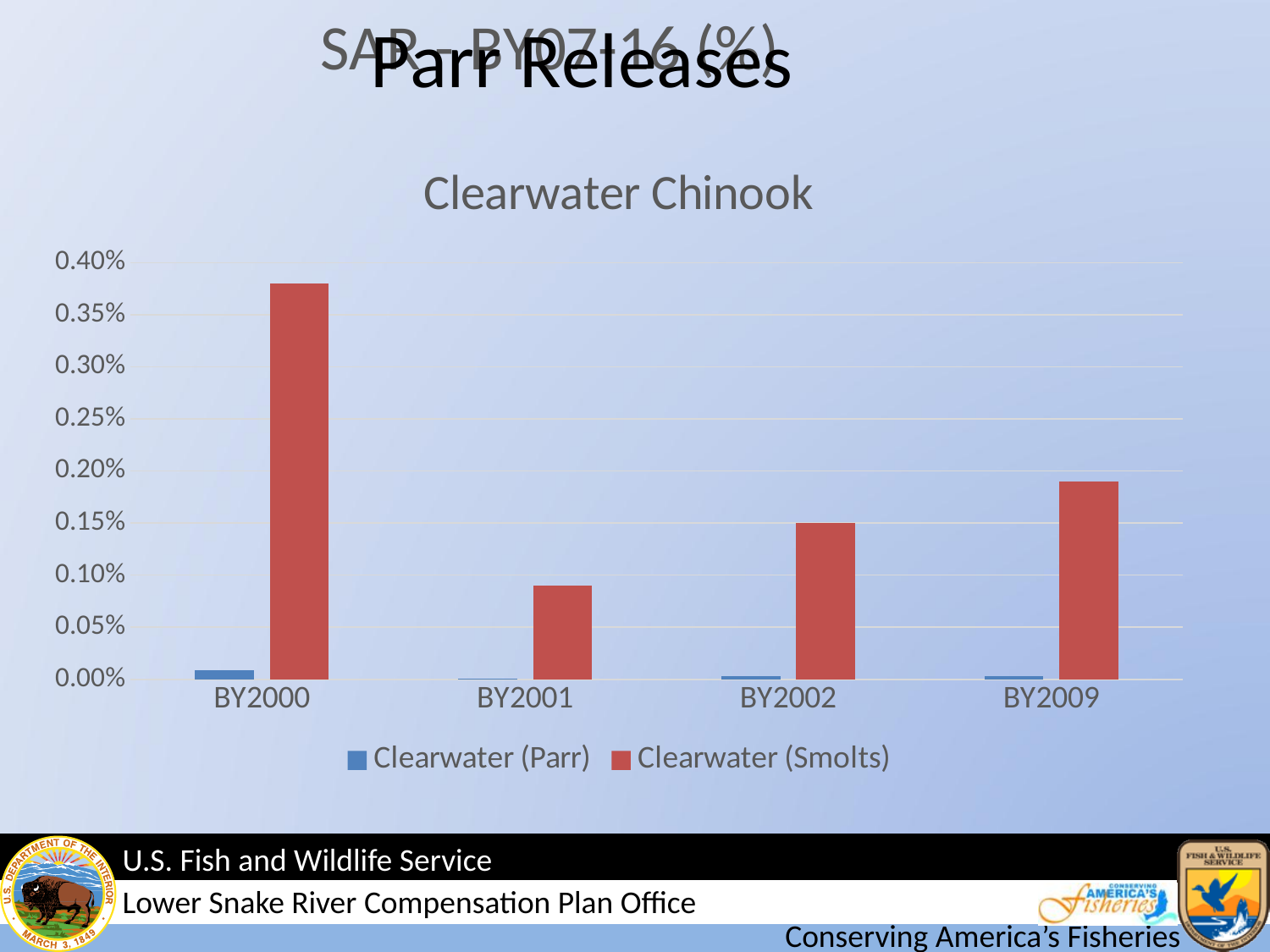
Is the Clearwater (Smolts) value for BY2009 greater or less than 0.15%? greater How many series does the chart's legend list? 2 What kind of chart is shown on the slide? bar chart How many brood-year categories are shown on the x axis of the chart? 4 What is the title of the chart? Clearwater Chinook Is the Clearwater (Smolts) value for BY2000 greater or less than 0.30%? greater Which is larger, the Clearwater (Smolts) value for BY2002 or for BY2009? BY2009 Which brood year has the highest Clearwater (Smolts) value? BY2000 Is the Clearwater (Smolts) value for BY2001 greater or less than 0.10%? less Which brood year has the lowest Clearwater (Smolts) value? BY2001 For BY2000, which series has the larger value, Clearwater (Parr) or Clearwater (Smolts)? Clearwater (Smolts)